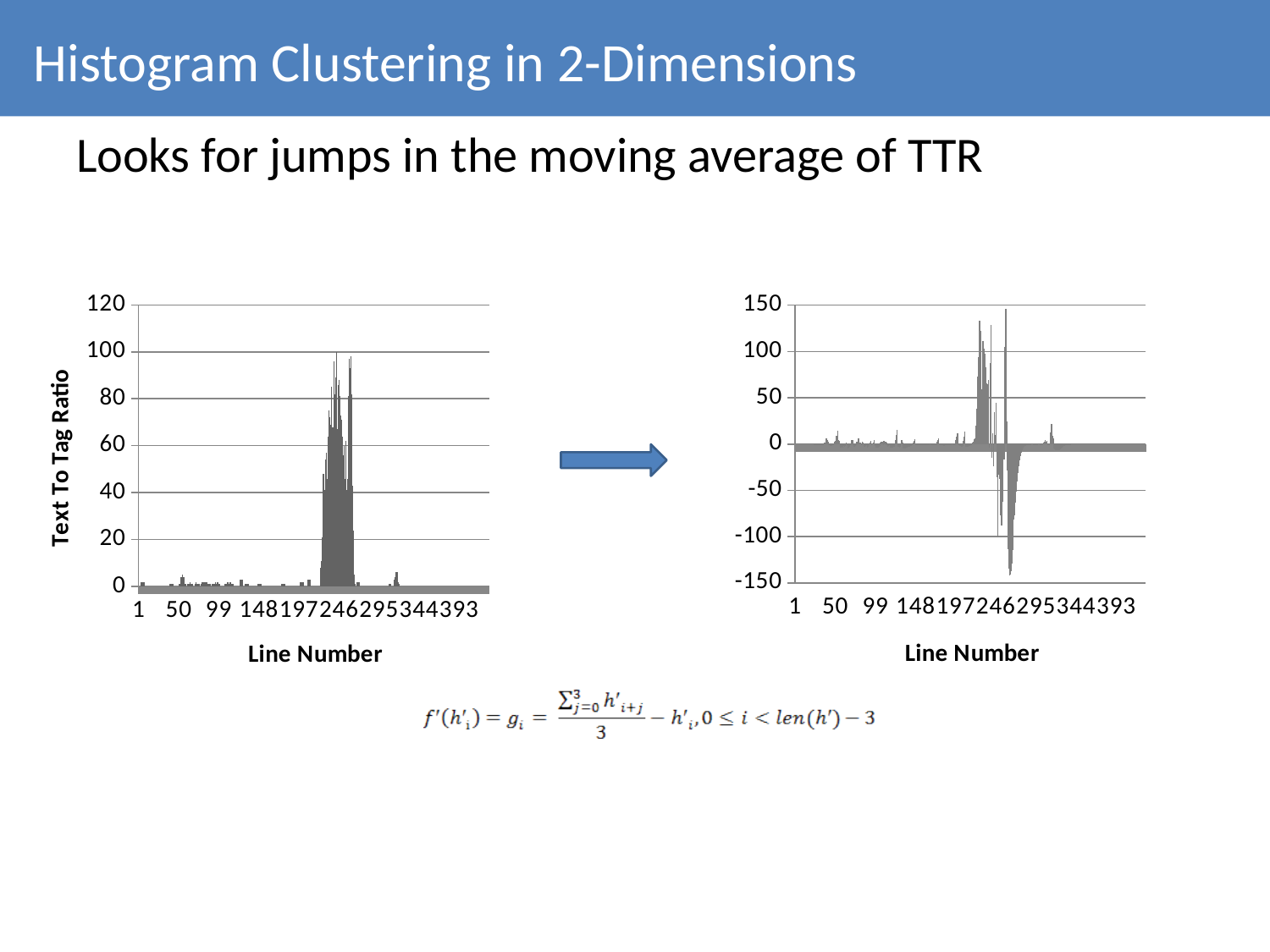
What is the maximum value shown on the y axis of the right chart? 150 In the left chart, is the value at line number 1 greater or less than 20? less In the left chart, is the highest Text To Tag Ratio value greater or less than 80? greater In the right chart, is the highest positive value greater or less than 100? greater What kind of chart is the left chart on the slide? bar chart What is the x-axis title of the right chart? Line Number How many tick labels are shown on the x axis of the left chart? 9 What is the y-axis title of the left chart? Text To Tag Ratio